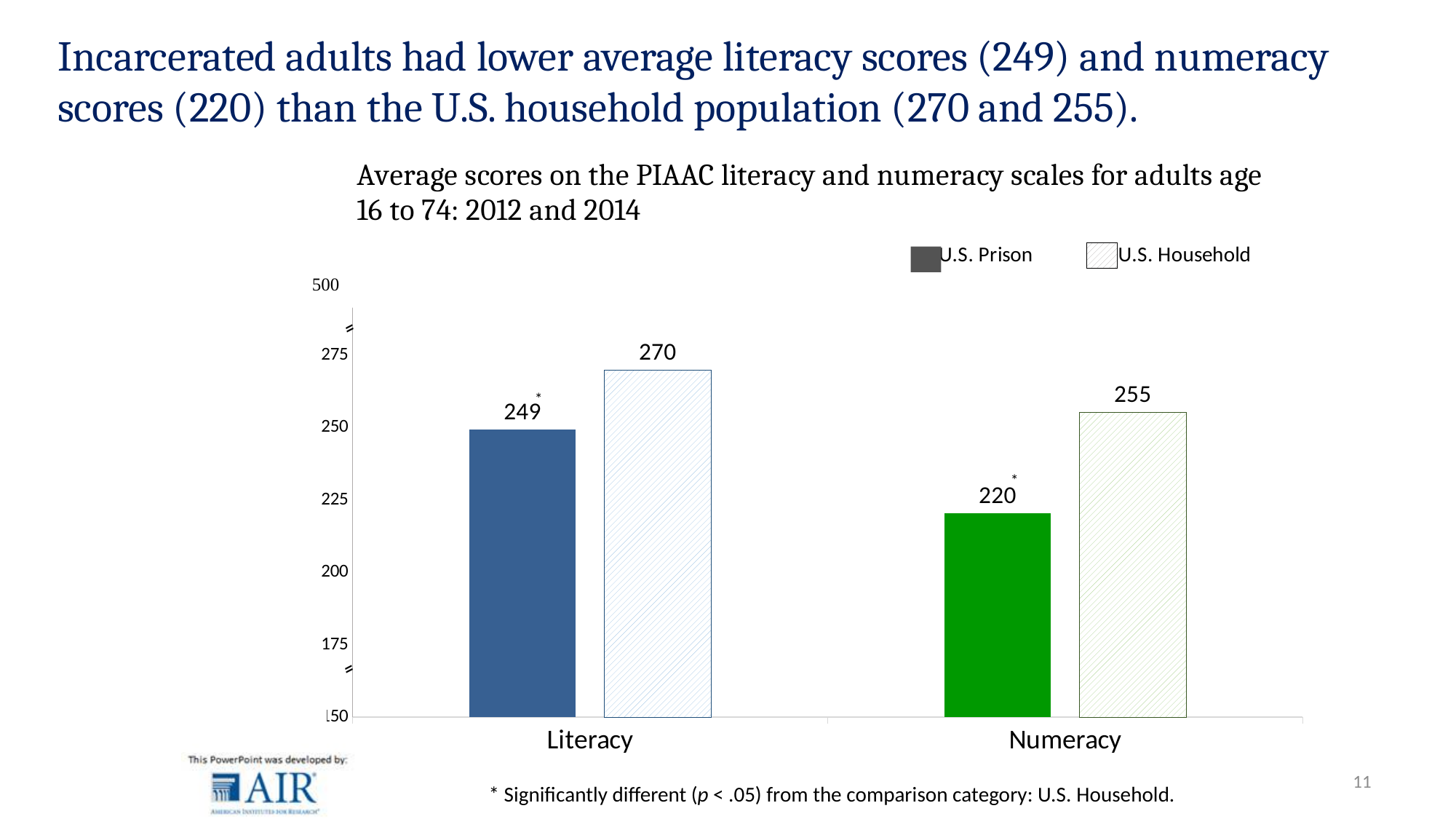
What is the difference between the U.S. Household and U.S. Prison literacy scores? 21 What is the difference between the U.S. Household and U.S. Prison numeracy scores? 35 Which bar shows the highest score on the chart? U.S. Household, Literacy What is the average numeracy score for the U.S. Prison population? 220 How many categories are shown on the x axis? 2 What is the average numeracy score for the U.S. Household population? 255 What type of chart is shown on the slide? Bar chart Which is larger: the U.S. Prison literacy score or the U.S. Household numeracy score? U.S. Household numeracy score Which bar shows the lowest score on the chart? U.S. Prison, Numeracy What is the average literacy score for the U.S. Household population? 270 What is the average literacy score for the U.S. Prison population? 249 How many series does the legend list? 2